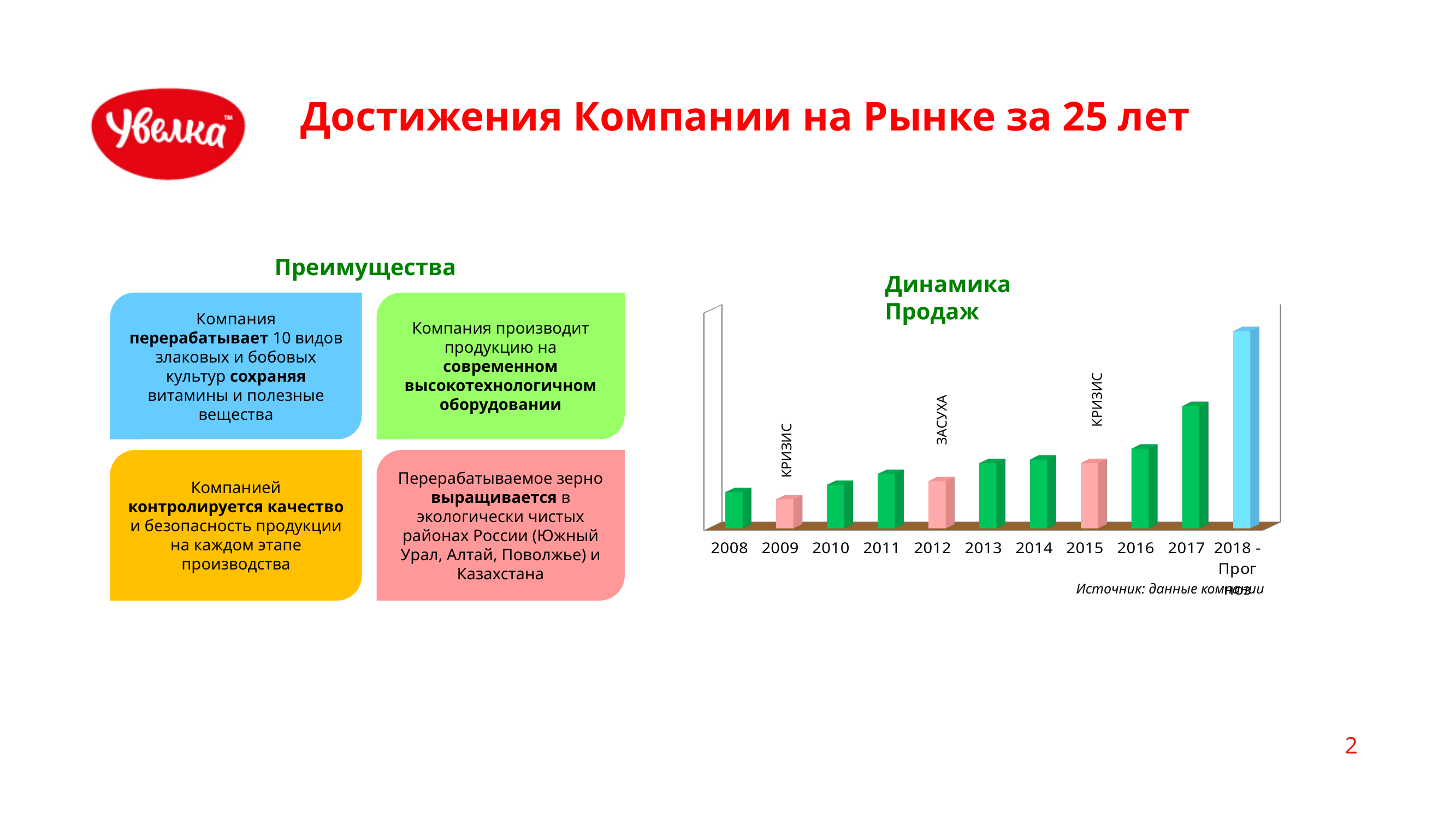
In the "Динамика Продаж" chart, which bar is taller, 2016 or 2017? 2017 Which year has the shortest bar in the "Динамика Продаж" chart? 2009 In the "Динамика Продаж" chart, which bar is taller, 2010 or 2011? 2011 Do the bars in the "Динамика Продаж" chart generally rise or fall from 2008 to 2018? rise How many years (categories) are shown on the x axis of the "Динамика Продаж" chart? 11 What is the title of the chart on the right side of the slide? Динамика Продаж In the "Динамика Продаж" chart, which bar is taller, 2008 or 2009? 2008 Which year has the tallest bar in the "Динамика Продаж" chart? 2018 - Прогноз Which years in the "Динамика Продаж" chart are annotated with the word "КРИЗИС"? 2009 and 2015 What kind of chart is shown under the title "Динамика Продаж"? bar chart